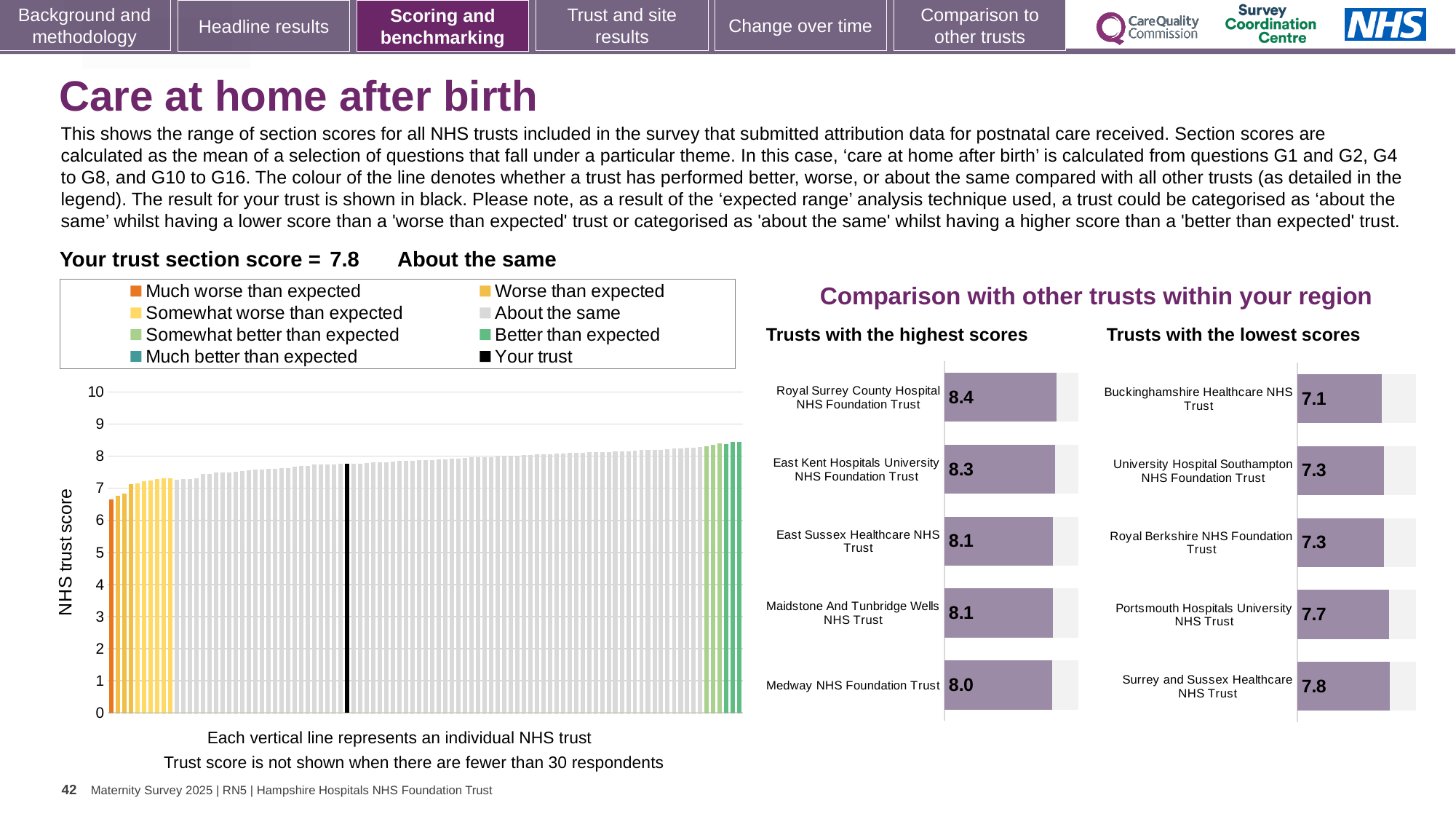
In the 'Trusts with the lowest scores' chart, which trust has the lowest score? Buckinghamshire Healthcare NHS Trust In the large 'NHS trust score' chart on the left, do the values rise or fall from left to right? Rise How many trusts are shown in the 'Trusts with the highest scores' chart? 5 In the 'Trusts with the lowest scores' chart, which has the larger score: Portsmouth Hospitals University NHS Trust or University Hospital Southampton NHS Foundation Trust? Portsmouth Hospitals University NHS Trust How many entries does the legend of the large 'NHS trust score' chart on the left list? 8 In the 'Trusts with the lowest scores' chart, what is the score for Buckinghamshire Healthcare NHS Trust? 7.1 In the 'Trusts with the highest scores' chart, what is the score for Medway NHS Foundation Trust? 8.0 In the 'Trusts with the highest scores' chart, which trust has the highest score? Royal Surrey County Hospital NHS Foundation Trust In the 'Trusts with the lowest scores' chart, what is the difference between the scores of Surrey and Sussex Healthcare NHS Trust and Buckinghamshire Healthcare NHS Trust? 0.7 In the 'Trusts with the highest scores' chart, what is the score for Royal Surrey County Hospital NHS Foundation Trust? 8.4 What kind of chart is the large 'NHS trust score' chart on the left of the slide? Bar chart In the 'Trusts with the highest scores' chart, what is the difference between the scores of Royal Surrey County Hospital NHS Foundation Trust and Medway NHS Foundation Trust? 0.4